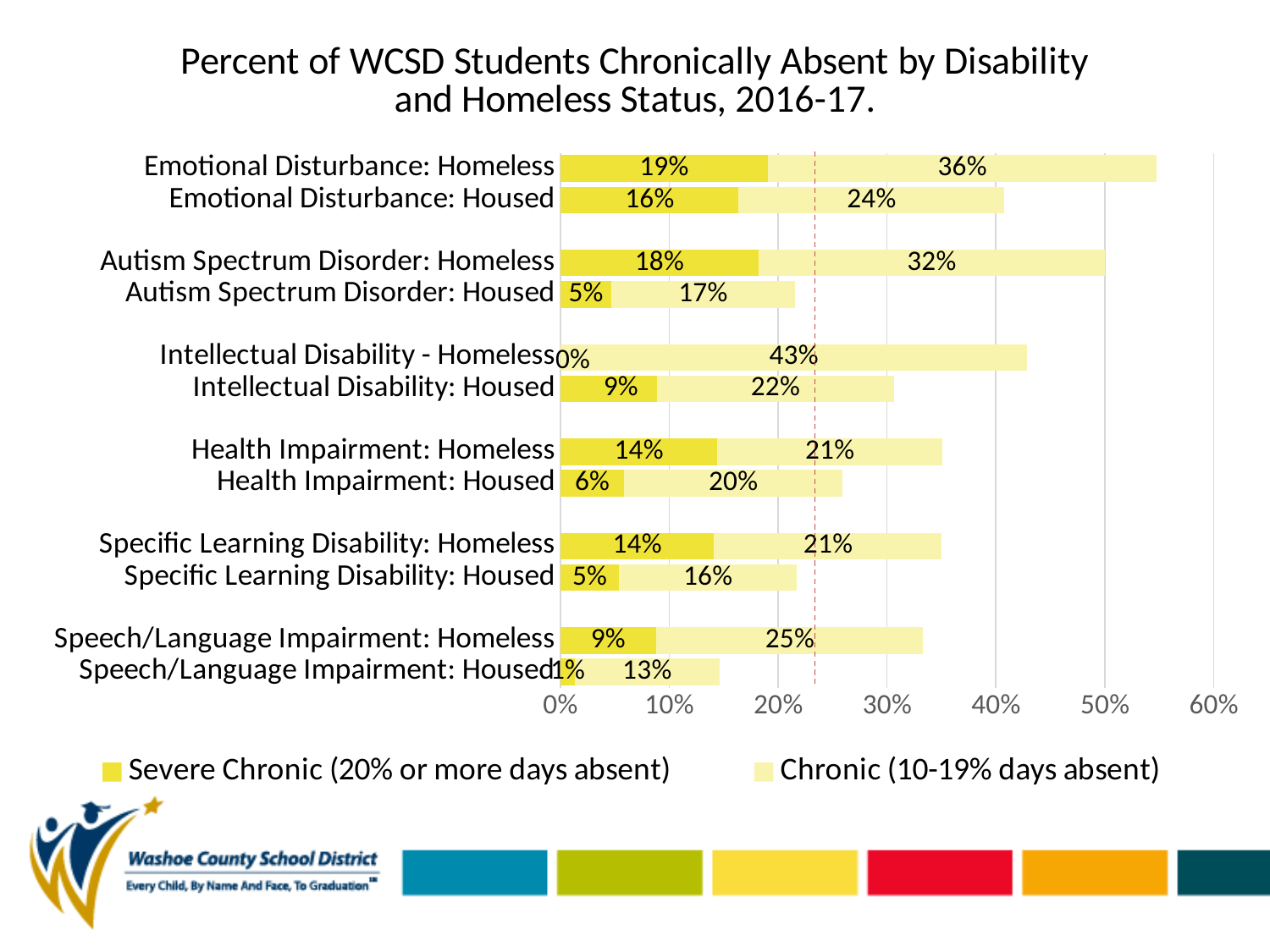
What type of chart is shown on the slide? Stacked bar chart Which is larger, the Severe Chronic value for Autism Spectrum Disorder: Homeless or for Autism Spectrum Disorder: Housed? Autism Spectrum Disorder: Homeless What is the Severe Chronic value for Emotional Disturbance: Homeless? 19% Which category has the highest Chronic (10-19% days absent) value? Intellectual Disability - Homeless What is the title of the chart? Percent of WCSD Students Chronically Absent by Disability and Homeless Status, 2016-17. What is the total of the stacked bar for Health Impairment: Housed? 26% Which category has the lowest Severe Chronic value? Intellectual Disability - Homeless What is the difference between the Chronic values for Emotional Disturbance: Homeless and Emotional Disturbance: Housed? 12% How many series does the legend list? 2 What is the Chronic (10-19% days absent) value for Intellectual Disability - Homeless? 43% How many categories are shown on the y axis? 12 What is the Severe Chronic value for Speech/Language Impairment: Housed? 1%